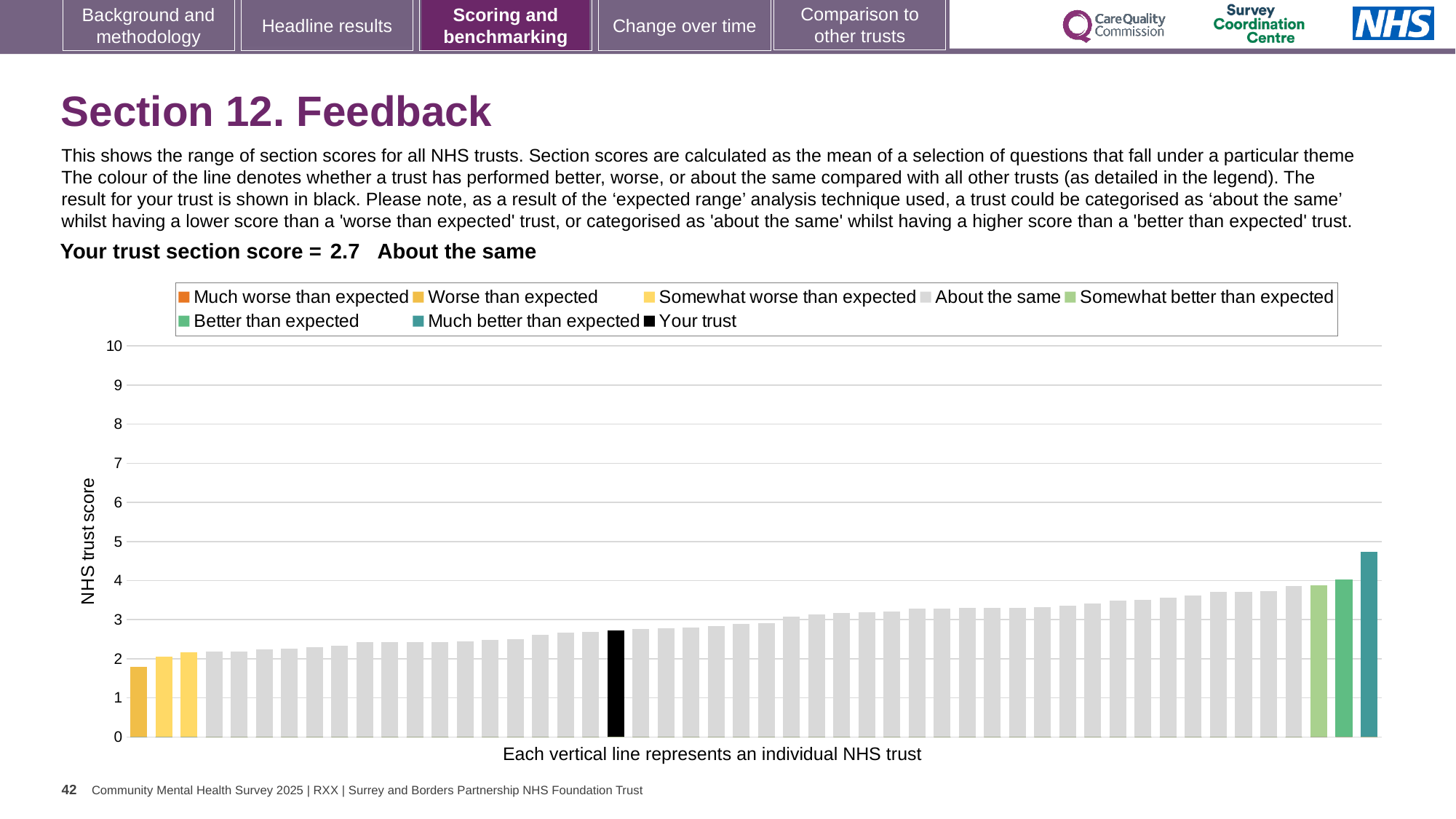
What is the label of the y axis? NHS trust score Do the bar values rise or fall from left to right along the x axis? rise How many bars are coloured in the yellow 'worse' shades at the left of the chart? 3 Which legend category does the tallest bar belong to? Much better than expected What is the highest value shown on the y axis? 10 Which legend category does the shortest bar belong to? Worse than expected What kind of chart is shown on the slide? bar chart Is the value for your trust (the black bar) greater or less than 2? greater Is the value of the tallest bar greater or less than 4? greater Is the value of the shortest bar greater or less than 2? less How many categories does the chart legend list? 8 What is the section score for your trust? 2.7